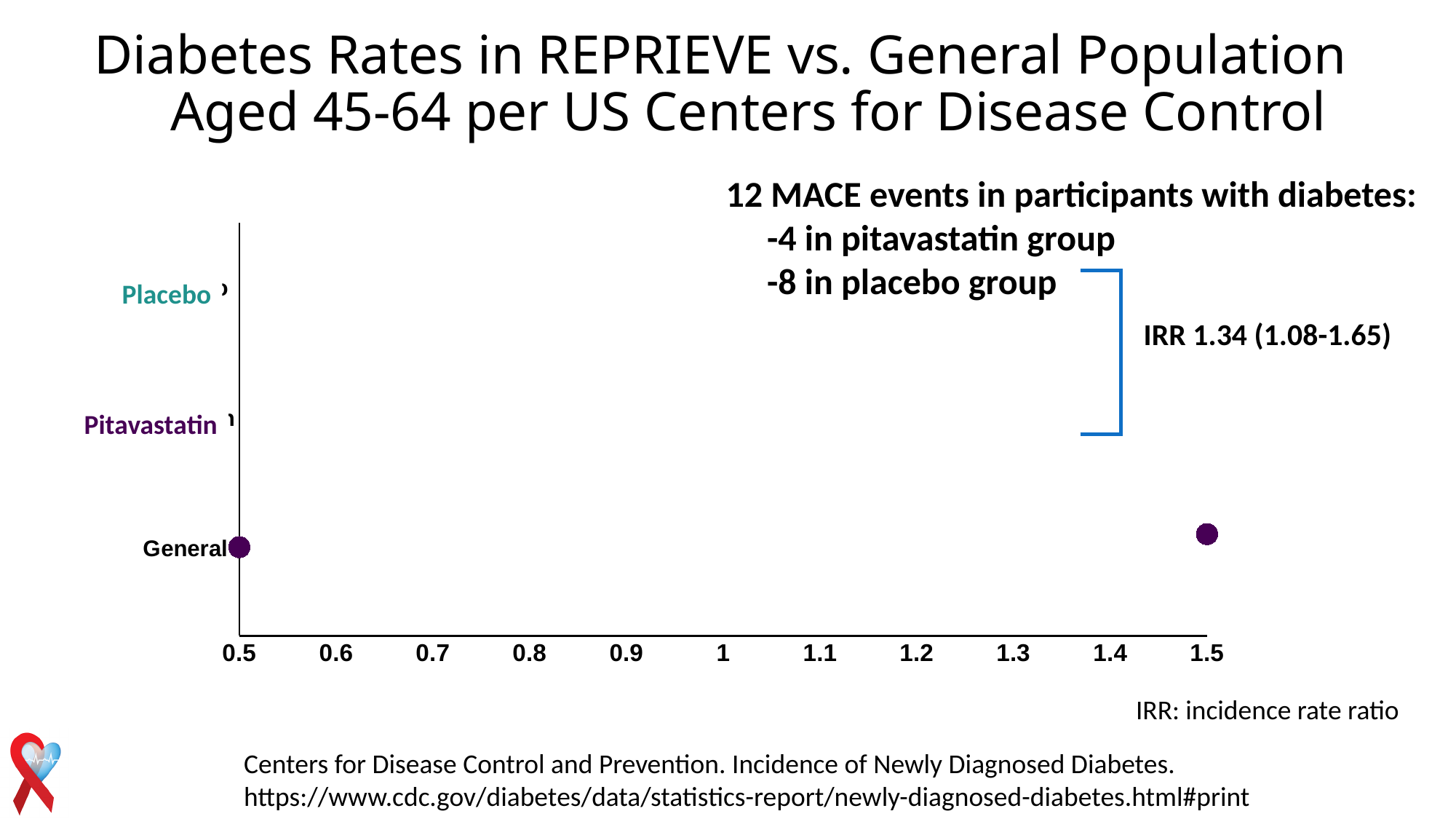
What is the lowest value shown on the horizontal axis of the chart? 0.5 At what horizontal-axis value does the leftmost point on the General row sit? 0.5 At what horizontal-axis value does the rightmost point on the General row sit? 1.5 How many points are plotted on the General row of the chart? 2 Is the rightmost point on the General row greater or less than 1.4 on the horizontal axis? greater What is the highest value shown on the horizontal axis of the chart? 1.5 What kind of chart is shown on the slide? scatter (dot) chart Is the leftmost point on the General row greater or less than 1 on the horizontal axis? less What are the three categories labelled on the vertical axis of the chart? Placebo, Pitavastatin, General How many categories are labelled on the vertical axis of the chart? 3 Which of the two points on the General row is further to the right, the one at 0.5 or the one at 1.5? the one at 1.5 What is the difference between the two horizontal-axis values of the points on the General row? 1